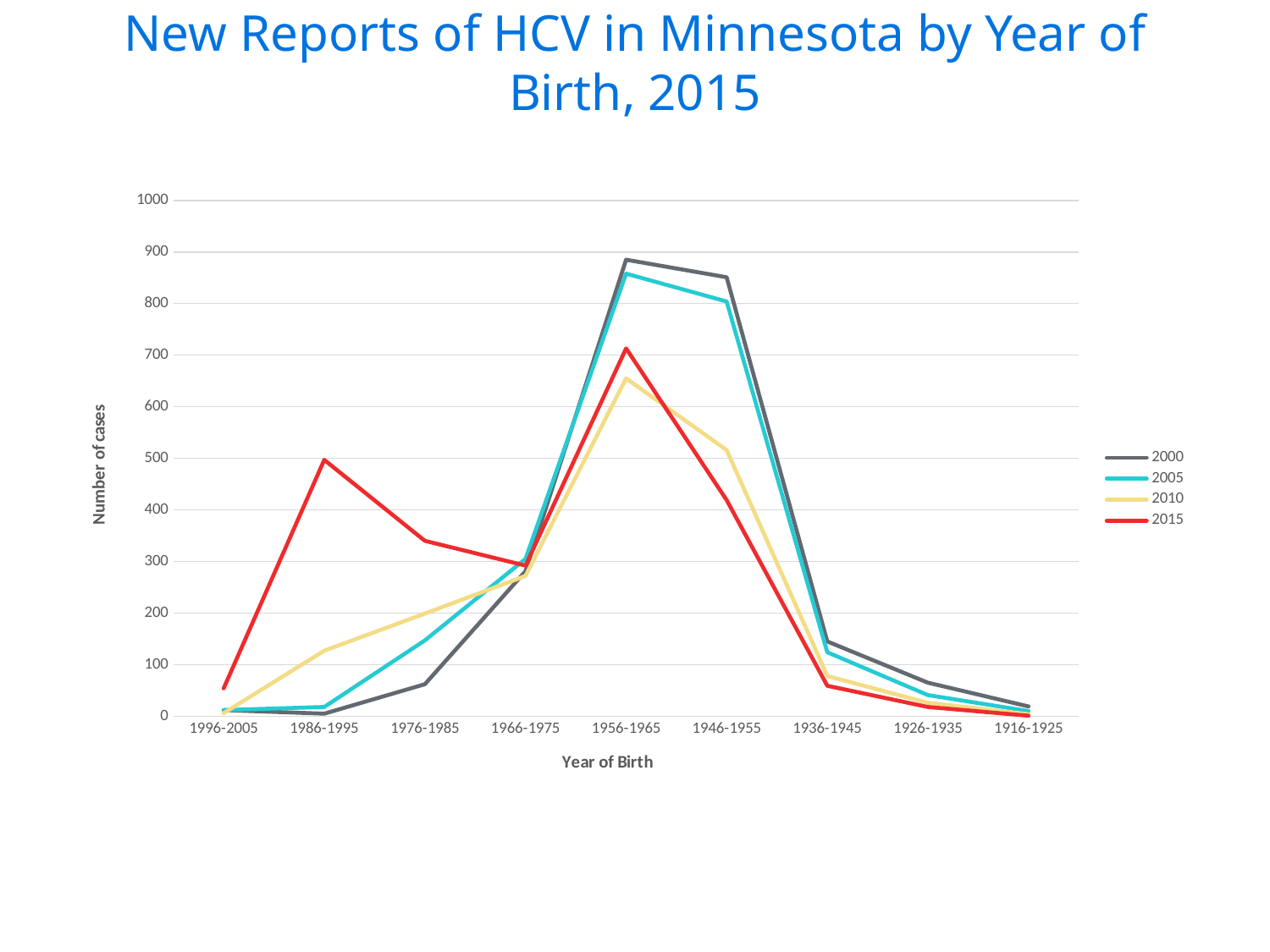
At the 1946-1955 category, which series is larger, 2000 or 2010? 2000 At the 1986-1995 category, which series is larger, 2015 or 2010? 2015 At the 1956-1965 category, which series has the lowest number of cases? 2010 How many year-of-birth categories are shown on the x axis? 9 Is the value for the 2015 series at 1986-1995 greater or less than 400? greater What is the title of the x axis? Year of Birth How many series does the legend list? 4 Is the value for the 2000 series at 1986-1995 greater or less than 100? less Is the value for the 2010 series at 1956-1965 greater or less than 600? greater What type of chart is shown on the slide? line chart For the 2015 series, which year-of-birth category has the highest number of cases? 1956-1965 At the 1996-2005 category, which series has the highest number of cases? 2015